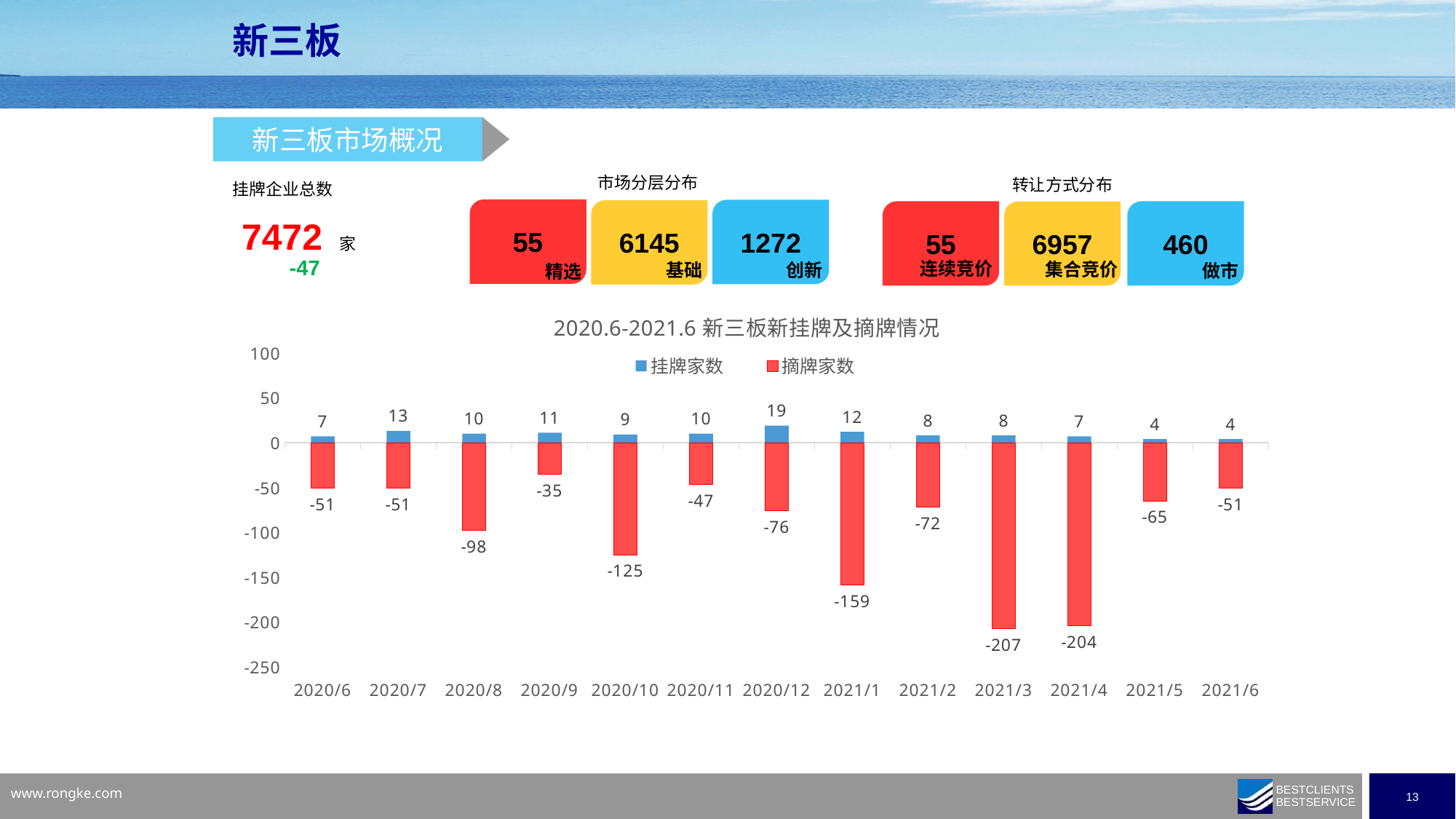
Which month has the lowest (most negative) 摘牌家数 value? 2021/3 Which month has the highest 挂牌家数 value? 2020/12 Which is larger in magnitude, the 摘牌家数 for 2020/10 or for 2020/12? 2020/10 Is the 摘牌家数 value for 2021/1 greater or less than -100? less How many months (categories) are shown on the x axis of the chart? 13 What is the 挂牌家数 value for 2020/12? 19 What is the 摘牌家数 value for 2020/9? -35 What is the title of the chart? 2020.6-2021.6 新三板新挂牌及摘牌情况 How many series does the chart legend list? 2 What is the difference between the 挂牌家数 values for 2020/7 and 2021/5? 9 What is the 摘牌家数 value for 2021/3? -207 What type of chart is shown on the slide? bar chart